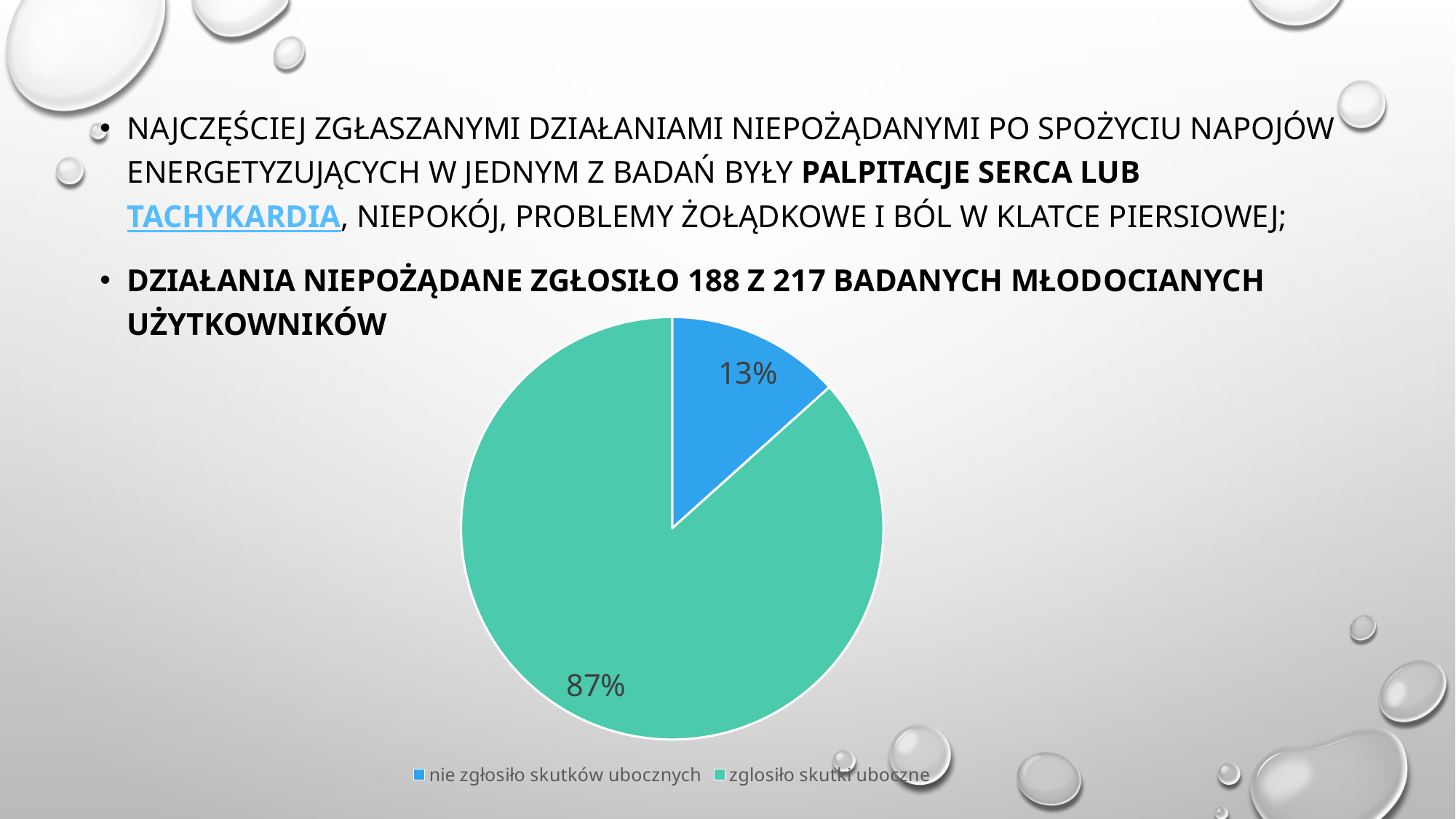
How many entries does the legend list? 2 What colour is the "nie zgłosiło skutków ubocznych" slice? blue What kind of chart is shown on the slide? pie chart Which slice of the pie is the largest? zglosiło skutki uboczne Which is larger: the "nie zgłosiło skutków ubocznych" slice or the "zglosiło skutki uboczne" slice? zglosiło skutki uboczne What is the difference in percentage points between the "zglosiło skutki uboczne" slice and the "nie zgłosiło skutków ubocznych" slice? 74 percentage points What share of the pie is labelled "nie zgłosiło skutków ubocznych"? 13% How many slices does the pie chart have? 2 What colour is the "zglosiło skutki uboczne" slice? green What share of the pie is labelled "zglosiło skutki uboczne"? 87% Which slice of the pie is the smallest? nie zgłosiło skutków ubocznych